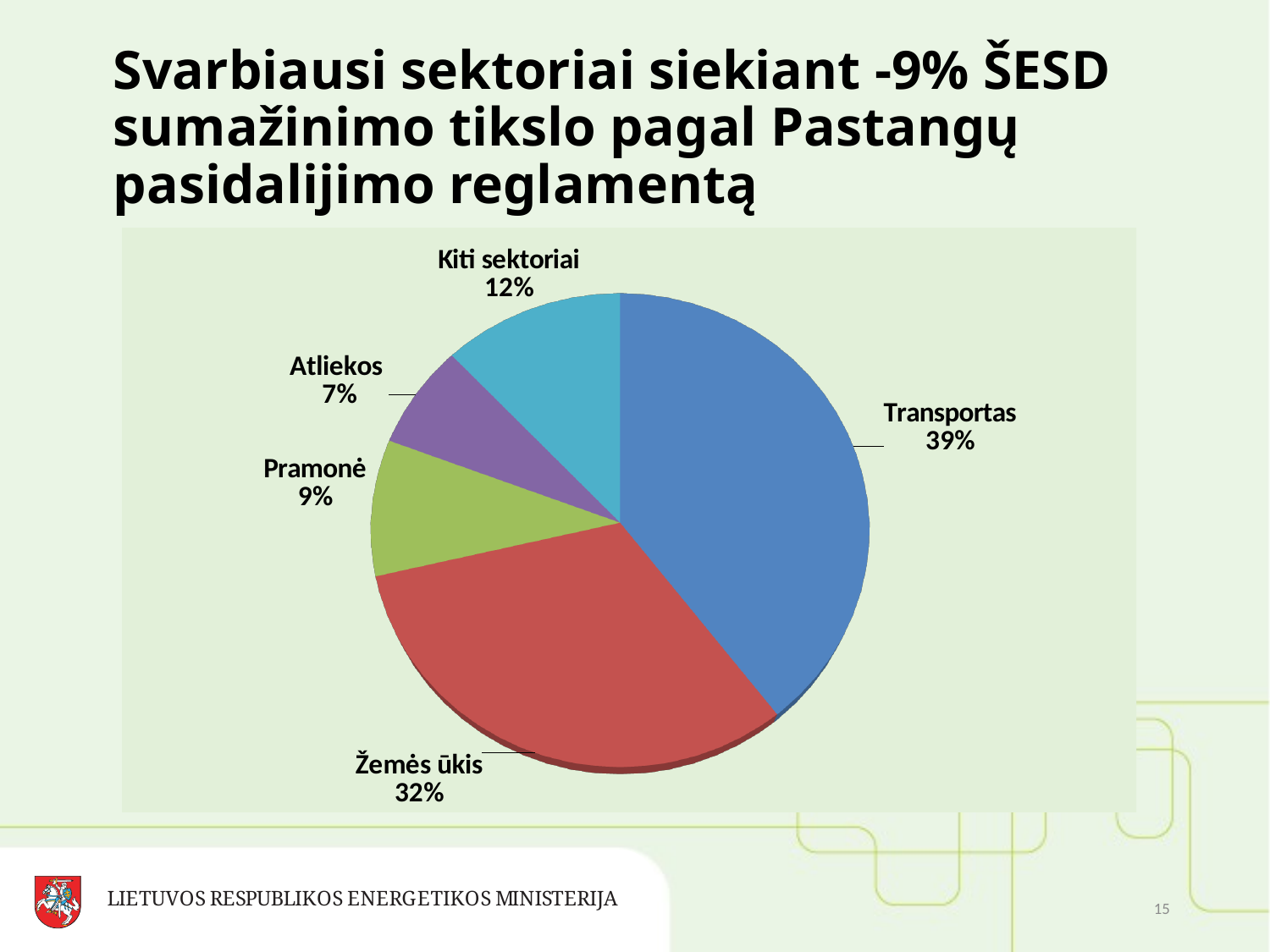
What share of the pie does Kiti sektoriai have? 12% Which sector has the largest share of the pie? Transportas What share of the pie does Atliekos have? 7% Which has a larger share, Kiti sektoriai or Pramonė? Kiti sektoriai What share of the pie does Pramonė have? 9% What colour is the Žemės ūkis slice? red Which sector has the smallest share of the pie? Atliekos What type of chart is shown on the slide? pie chart What share of the pie does Transportas have? 39% What share of the pie does Žemės ūkis have? 32% How many slices does the pie chart have? 5 What is the difference in percentage points between Transportas and Žemės ūkis? 7